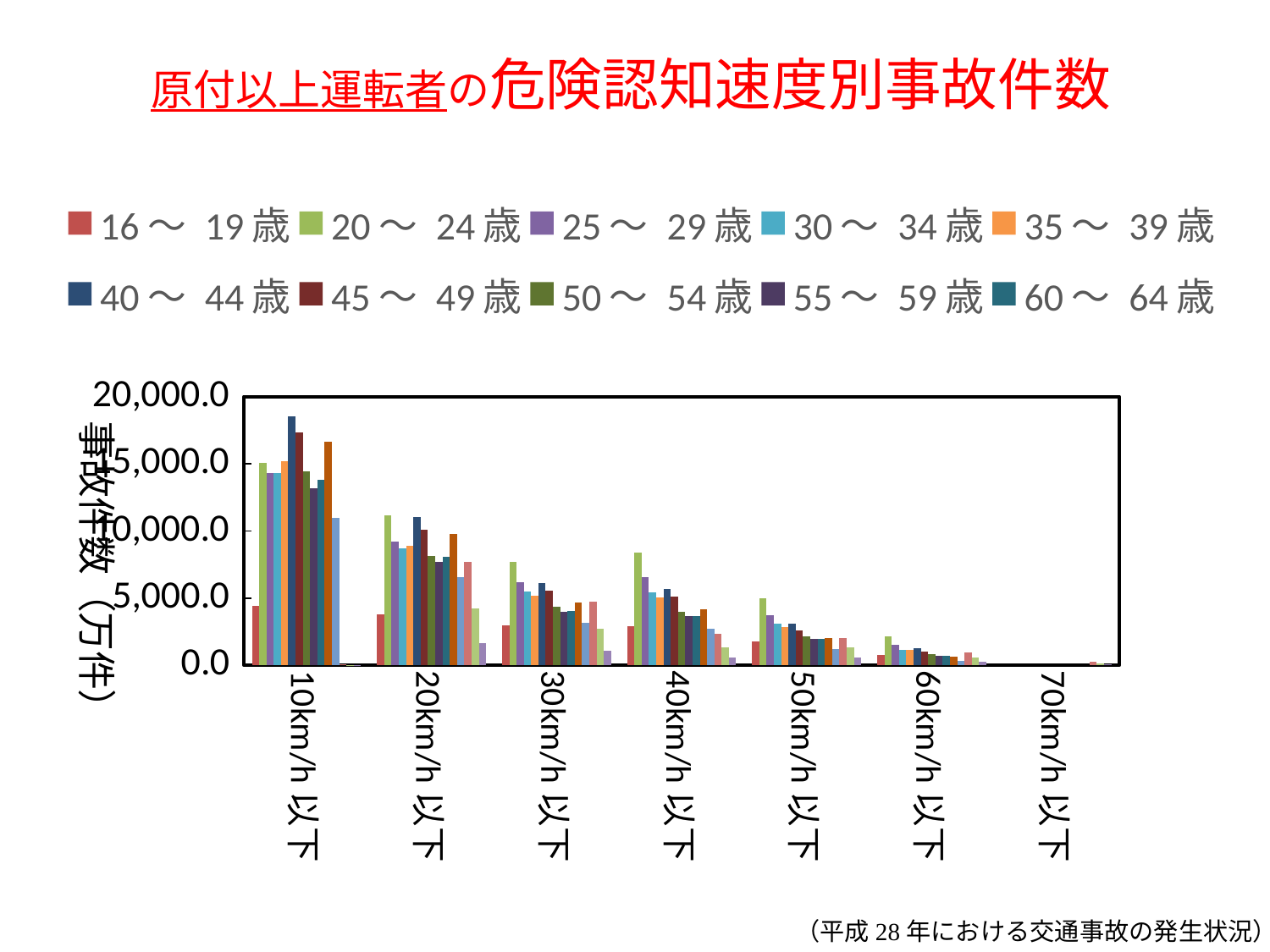
Do the accident counts rise or fall as the speed category increases along the x axis? fall Is the value for 20～24歳 at 40km/h以下 greater or less than 5,000.0? greater What is the label of the vertical axis? 事故件数（万件） Which speed category has the highest accident counts overall? 10km/h以下 How many age-group series does the legend list? 10 Which speed category has the lowest accident counts overall? 70km/h以下 How many speed categories are shown on the x axis? 7 Is the value for 40～44歳 at 10km/h以下 greater or less than 15,000.0? greater What kind of chart is shown on the slide? bar chart Is the value for 16～19歳 at 10km/h以下 greater or less than 5,000.0? less At 10km/h以下, which is larger: the value for 40～44歳 or the value for 16～19歳? 40～44歳